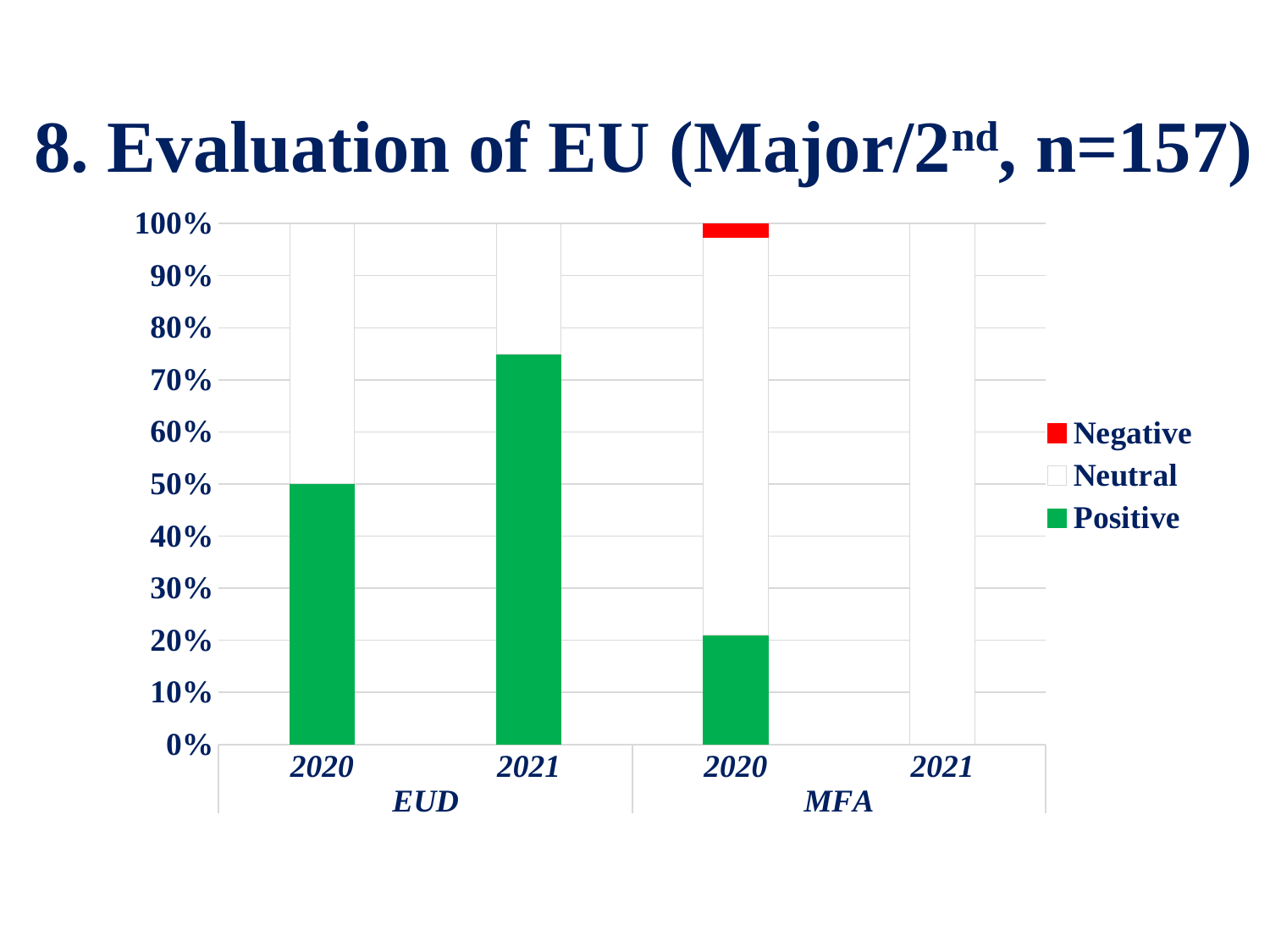
Which bar is the only one showing a Negative segment? MFA 2020 Is the Positive share for EUD in 2021 greater or less than 70%? greater Which bar has the highest Positive share? EUD 2021 How many bars (category/year combinations) are plotted on the chart? 4 Is the Negative share for MFA in 2020 greater or less than 10%? less For EUD, does the Positive share rise or fall from 2020 to 2021? rise Which colour represents Positive in the legend? Green Is the Positive share for MFA in 2020 greater or less than 30%? less What kind of chart is shown on the slide? Stacked bar chart Which is larger, the Positive share for EUD 2020 or for MFA 2020? EUD 2020 How many series does the legend list? 3 What is the Positive share for EUD in 2020? 50%